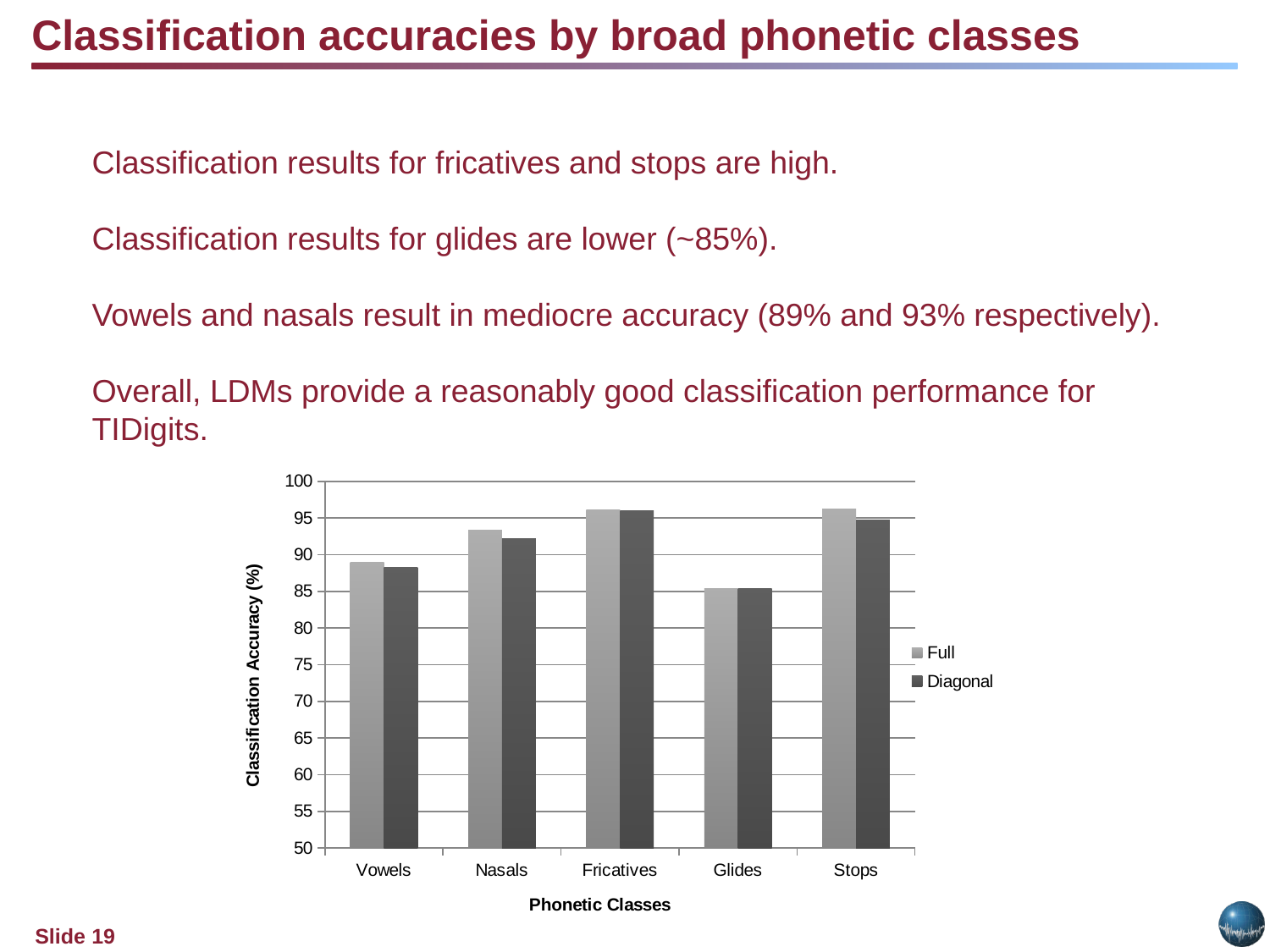
What is the label of the chart's y axis? Classification Accuracy (%) What kind of chart is shown on the slide? bar chart Which phonetic class has the lowest classification accuracy for the Full series? Glides Is the Diagonal classification accuracy for Vowels greater or less than 90? less Which is larger for the Full series: the classification accuracy for Nasals or for Vowels? Nasals Is the Diagonal classification accuracy for Nasals greater or less than 90? greater Which phonetic class has the lowest classification accuracy for the Diagonal series? Glides How many phonetic classes are shown on the x axis of the chart? 5 Which is larger for the Diagonal series: the classification accuracy for Stops or for Glides? Stops Is the Full classification accuracy for Vowels greater or less than 85? greater How many series does the chart's legend list? 2